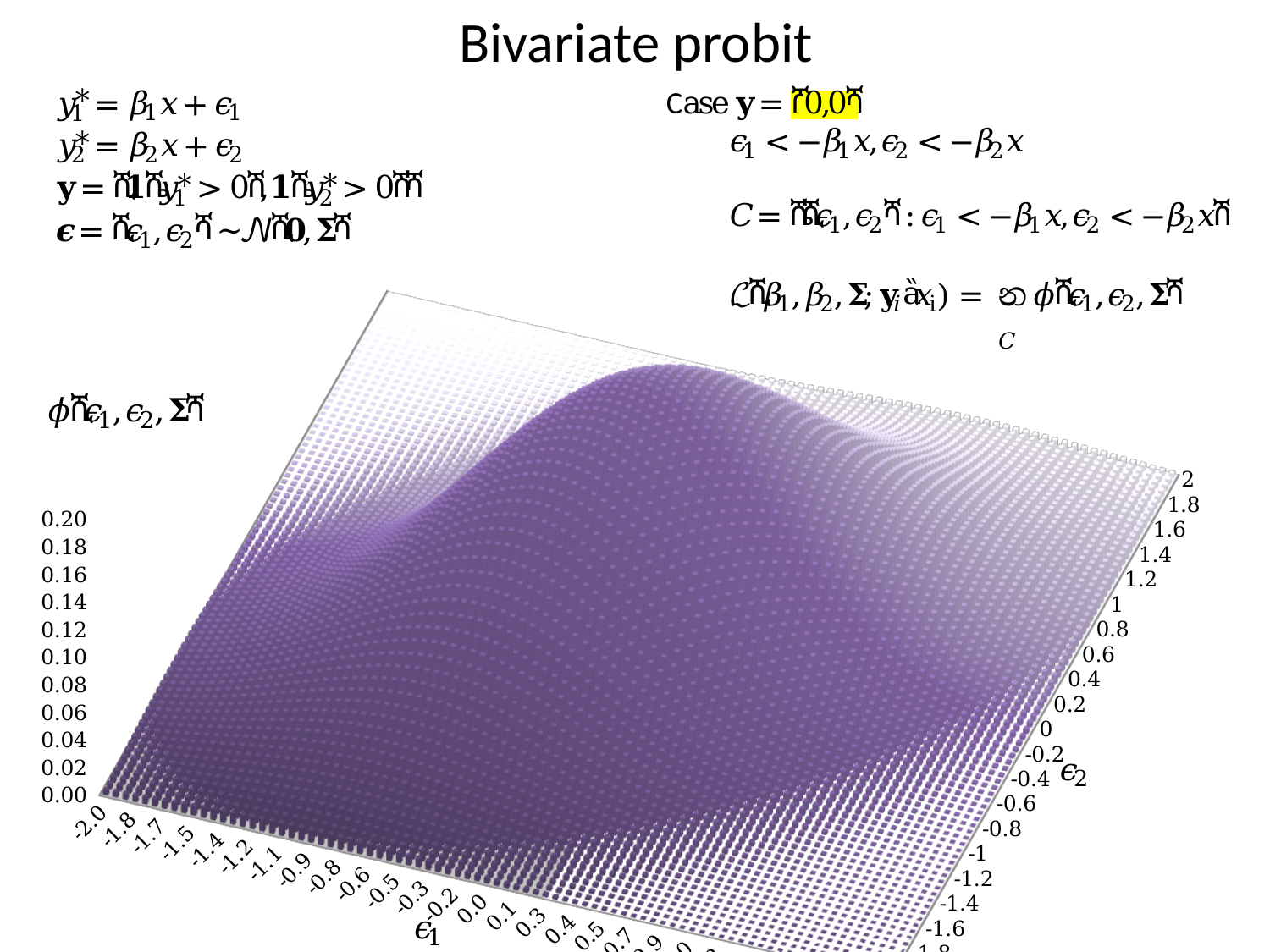
What is the title of the slide containing the chart? Bivariate probit What kind of chart is shown on the slide? 3D surface chart What is the highest tick value shown on the vertical axis of the chart? 0.20 What is the lowest tick value shown on the vertical axis of the chart? 0.00 What is the lowest tick value shown on the ε1 axis? -2.0 Does the surface rise or fall as ε1 moves from -2.0 toward 0? rise How many tick labels are shown on the vertical axis of the chart? 11 Is the peak value of the plotted surface greater or less than 0.02? greater What is the highest tick value shown on the ε2 axis? 2 What label is shown on the horizontal axis running along the front of the chart? ε1